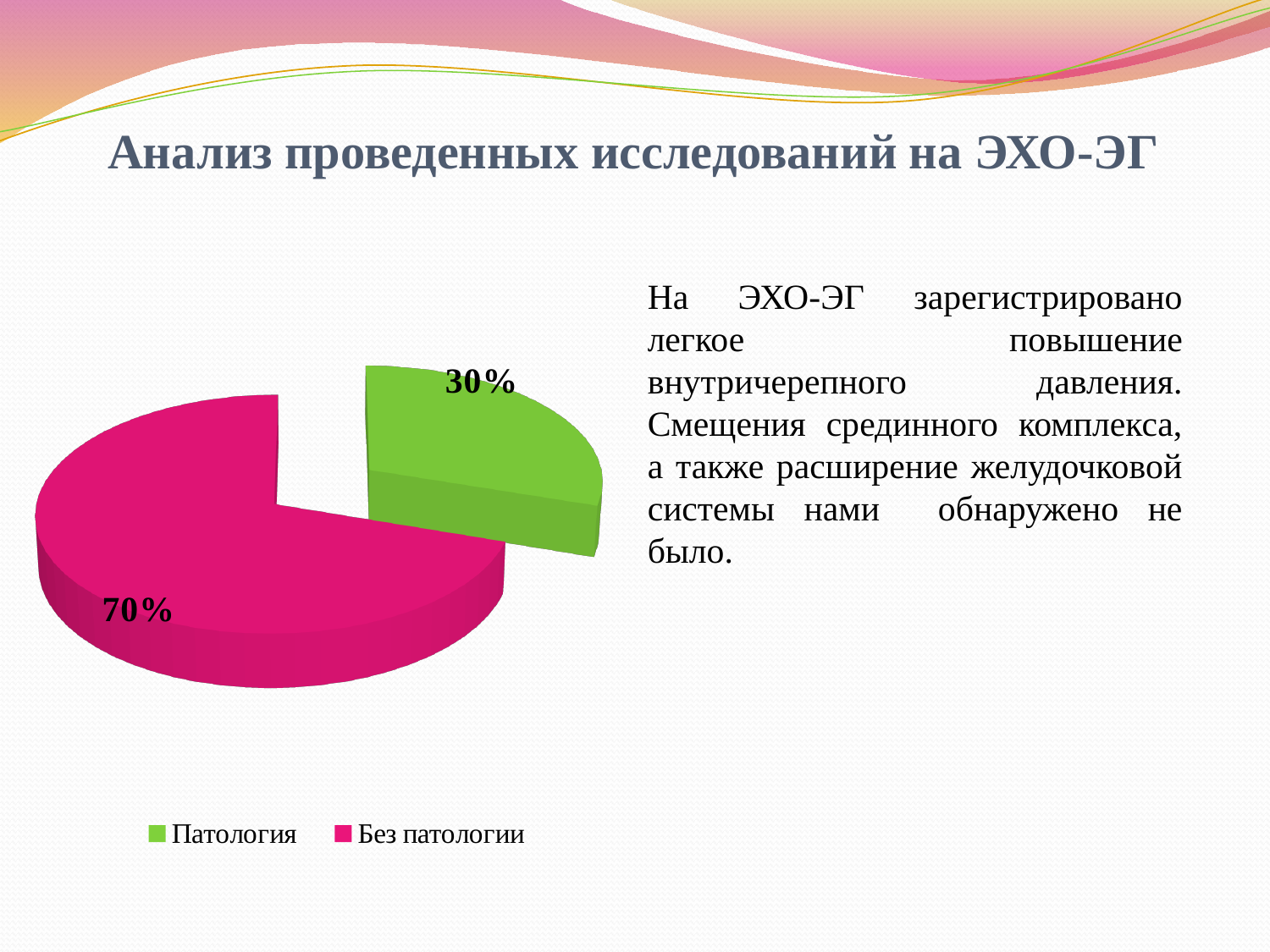
What is the difference in percentage points between "Без патологии" and "Патология"? 40% What colour is the "Патология" slice? green What kind of chart is shown on the slide? pie chart Which slice of the pie is the largest? Без патологии Which is larger, the share for "Патология" or the share for "Без патологии"? Без патологии What share of the pie does "Без патологии" represent? 70% Which slice of the pie is the smallest? Патология What colour is the "Без патологии" slice? pink What share of the pie does "Патология" represent? 30% How many entries does the legend list? 2 How many slices does the pie chart have? 2